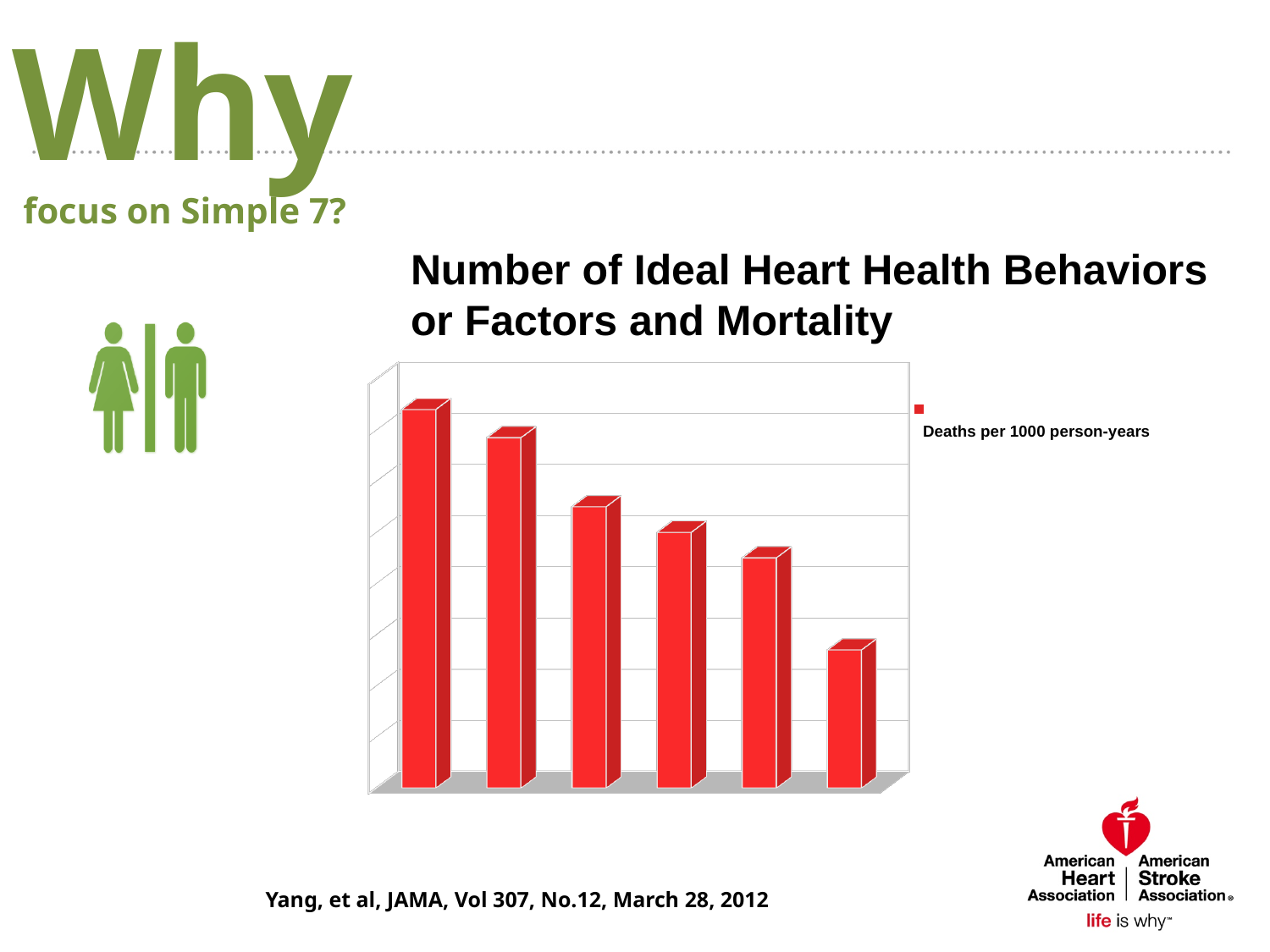
What is the title of the chart? Number of Ideal Heart Health Behaviors or Factors and Mortality Do the bar values rise or fall from left to right across the chart? fall Is the third bar from the left taller or shorter than the second bar? shorter Is the fifth bar from the left taller or shorter than the sixth bar? taller What kind of chart is shown on the slide? bar chart Which bar is the shortest in the chart, the leftmost or the rightmost? rightmost Is the first (leftmost) bar taller or shorter than the second bar? taller Which bar is the tallest in the chart, the leftmost or the rightmost? leftmost What is the series name shown in the chart's legend? Deaths per 1000 person-years How many bars are plotted in the chart? 6 How many series does the chart's legend list? 1